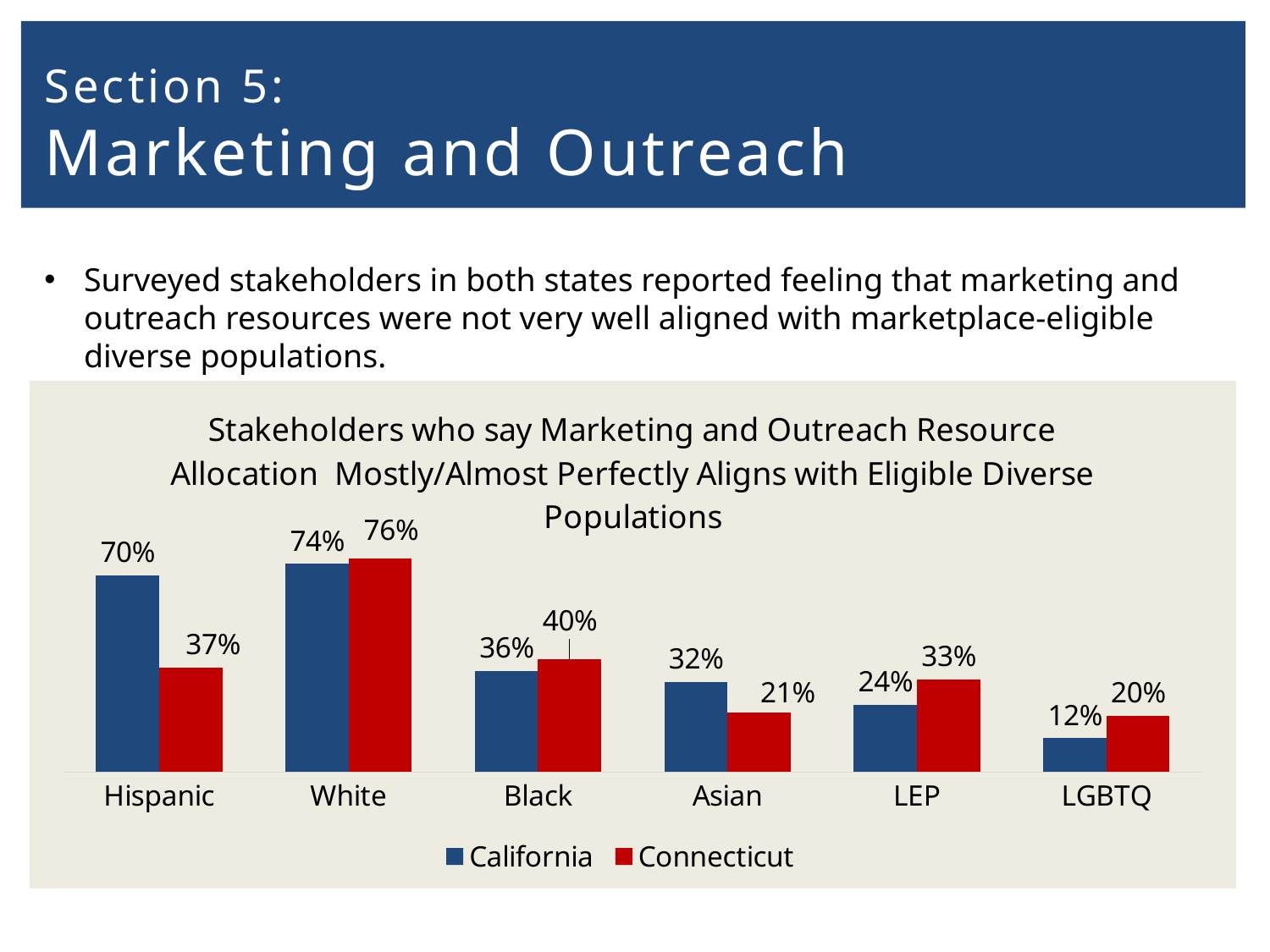
Which category has the highest Connecticut value? White Which colour represents Connecticut in the chart? Red How many population categories are shown on the x axis? 6 Which is larger for the Asian category, the California value or the Connecticut value? California What is the Connecticut value for the Black category? 40% What percentage of California stakeholders say marketing and outreach resource allocation aligns with the Hispanic population? 70% What is the California value for LGBTQ? 12% What kind of chart is shown on the slide? Bar chart How many series does the legend list? 2 What is the difference between the Connecticut values for White and LGBTQ? 56% What is the difference between the California and Connecticut values for Hispanic? 33% Which category has the lowest California value? LGBTQ